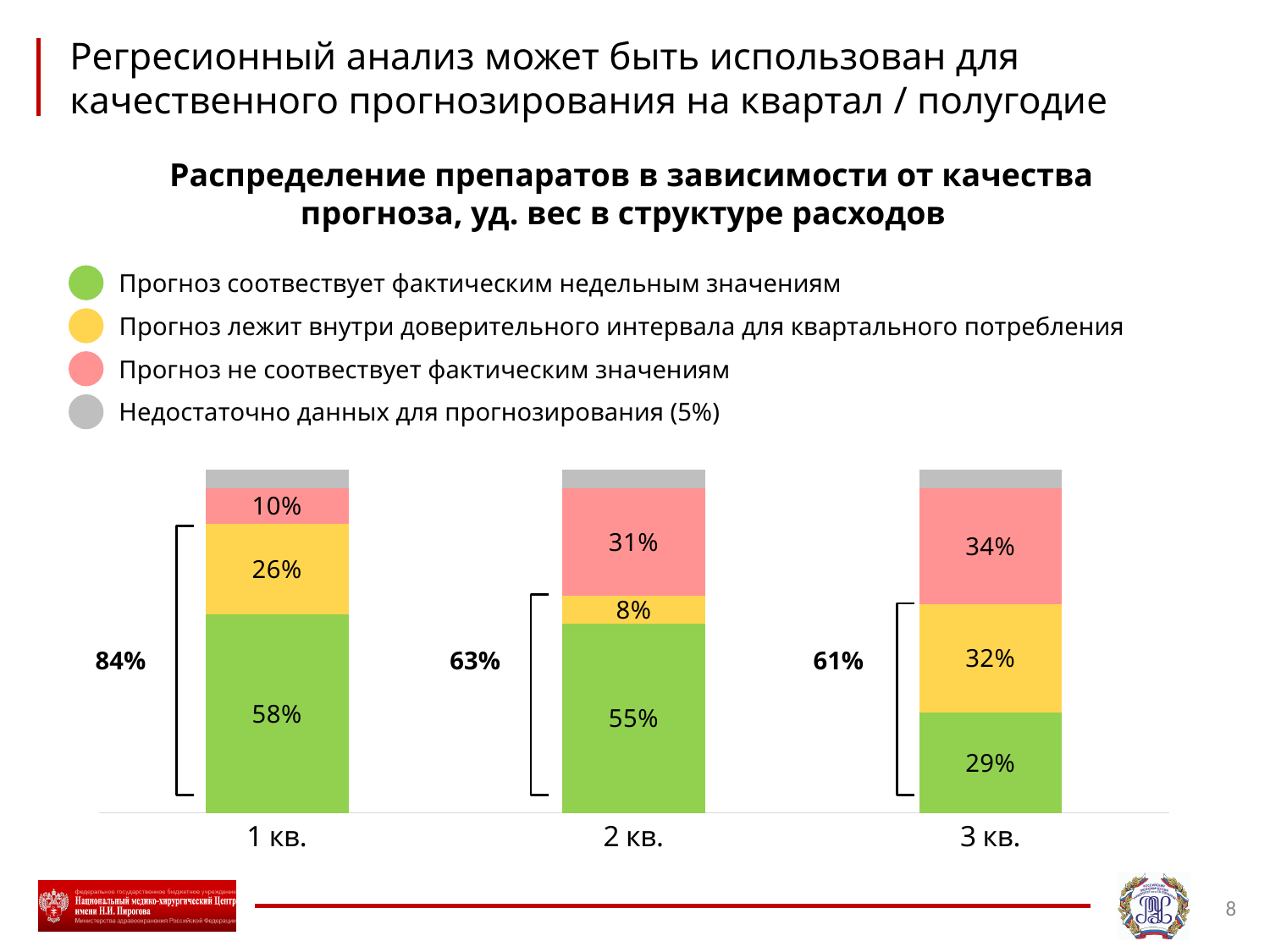
Which quarter has the lowest yellow segment value? 2 кв. How much larger is the red segment in 3 кв. than in 1 кв.? 24% What percentage of the 1 кв. bar is the green segment (Прогноз соответствует фактическим недельным значениям)? 58% What is the value of the red segment (Прогноз не соответствует фактическим значениям) for 2 кв.? 31% Does the green segment value rise or fall from 1 кв. to 3 кв.? Fall What is the value of the yellow segment (Прогноз лежит внутри доверительного интервала) for 3 кв.? 32% What kind of chart is shown on the slide? Stacked bar chart How many series does the legend list? 4 What combined share of green and yellow segments is marked by the bracket for 2 кв.? 63% Which quarter has a larger green segment, 2 кв. or 3 кв.? 2 кв. Which quarter has the highest green segment value? 1 кв. How many quarters are shown on the x axis? 3